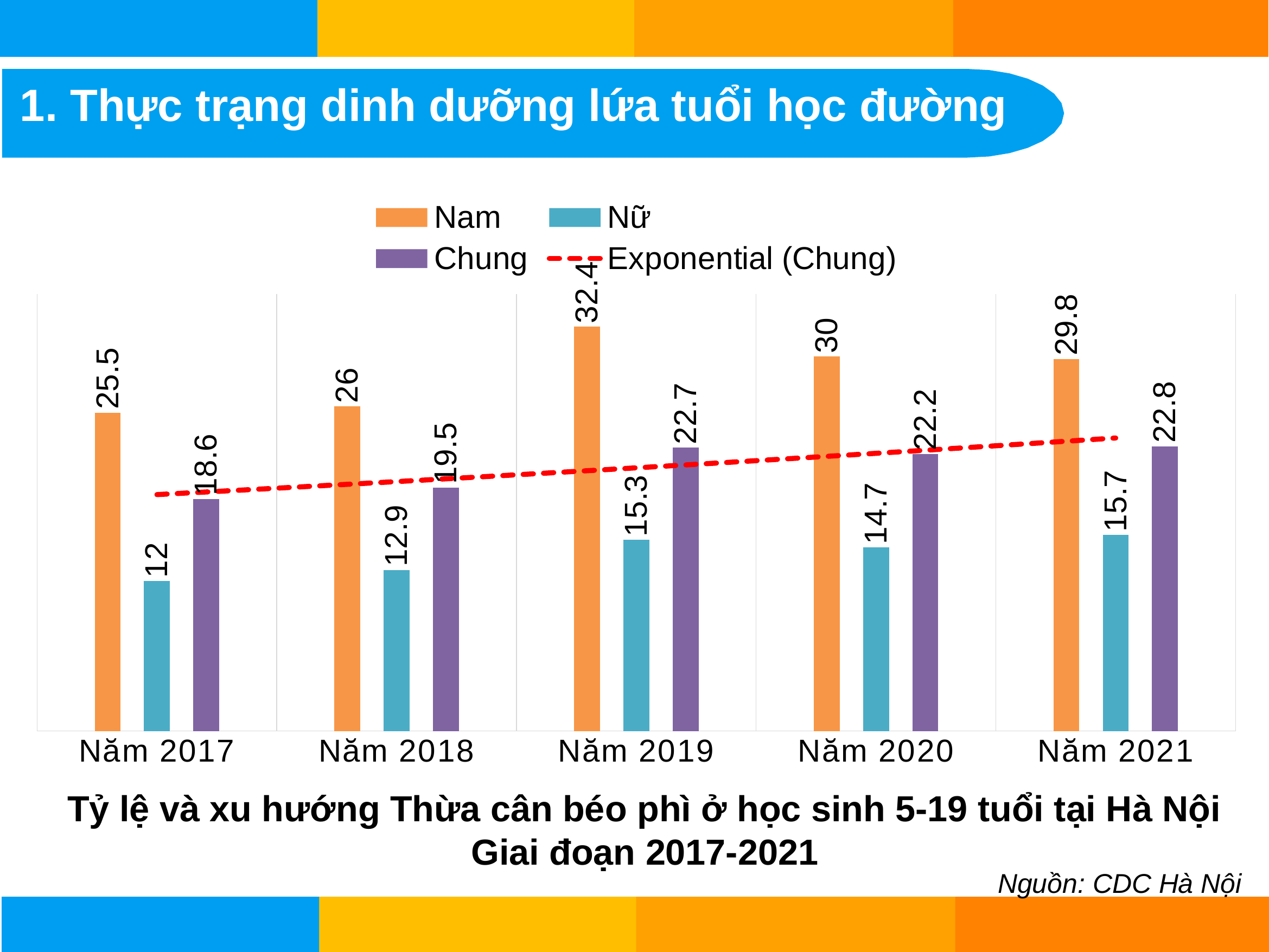
Does the Chung value rise or fall from Năm 2017 to Năm 2019? Rise What is the value for Chung in Năm 2021? 22.8 In which year is the Nữ value lowest? Năm 2017 What is the source cited below the chart? CDC Hà Nội What is the value for Nữ in Năm 2017? 12 What is the difference between the Nam and Nữ values in Năm 2020? 15.3 What is the value for Nam in Năm 2019? 32.4 How many years are shown on the x axis? 5 Which is larger, the Chung value in Năm 2018 or the Chung value in Năm 2020? Năm 2020 How many entries does the legend list? 4 What kind of chart is this? Bar chart In which year is the Nam value highest? Năm 2019